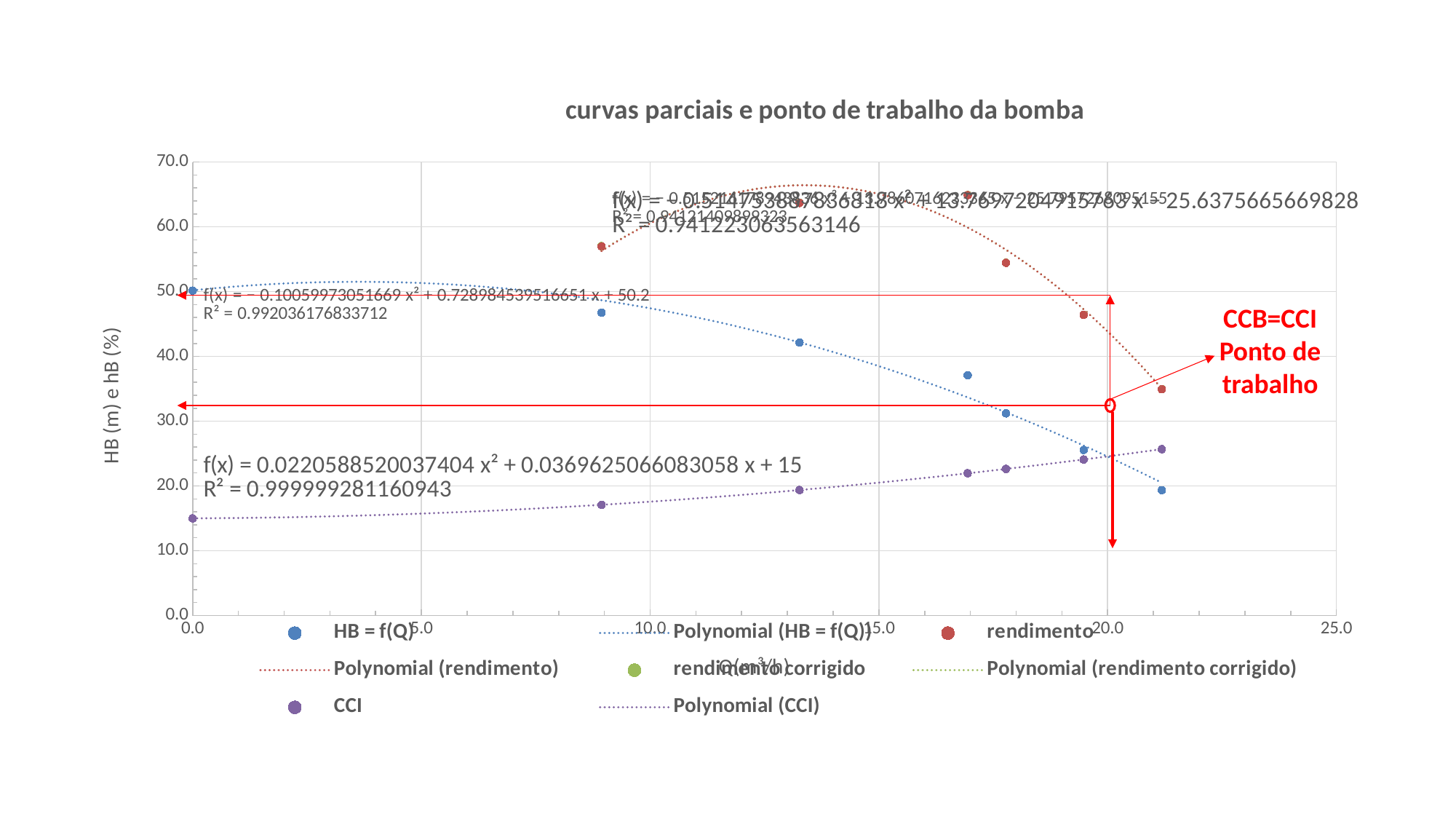
What is the title of the chart? curvas parciais e ponto de trabalho da bomba How many entries does the chart legend list? 8 What R² value is shown for the CCI polynomial trendline? 0.999999281160943 Is the highest rendimento point greater or less than 60.0? greater Does the HB = f(Q) series rise or fall as Q increases? fall How many data points are plotted for the HB = f(Q) series? 7 Is the rendimento value at the largest Q plotted greater or less than 40.0? less Is the CCI value at Q = 0.0 greater or less than 20.0? less What kind of chart is shown on the slide? scatter chart At Q = 0.0, which is larger: the HB = f(Q) value or the CCI value? HB = f(Q) Does the CCI series rise or fall as Q increases? rise